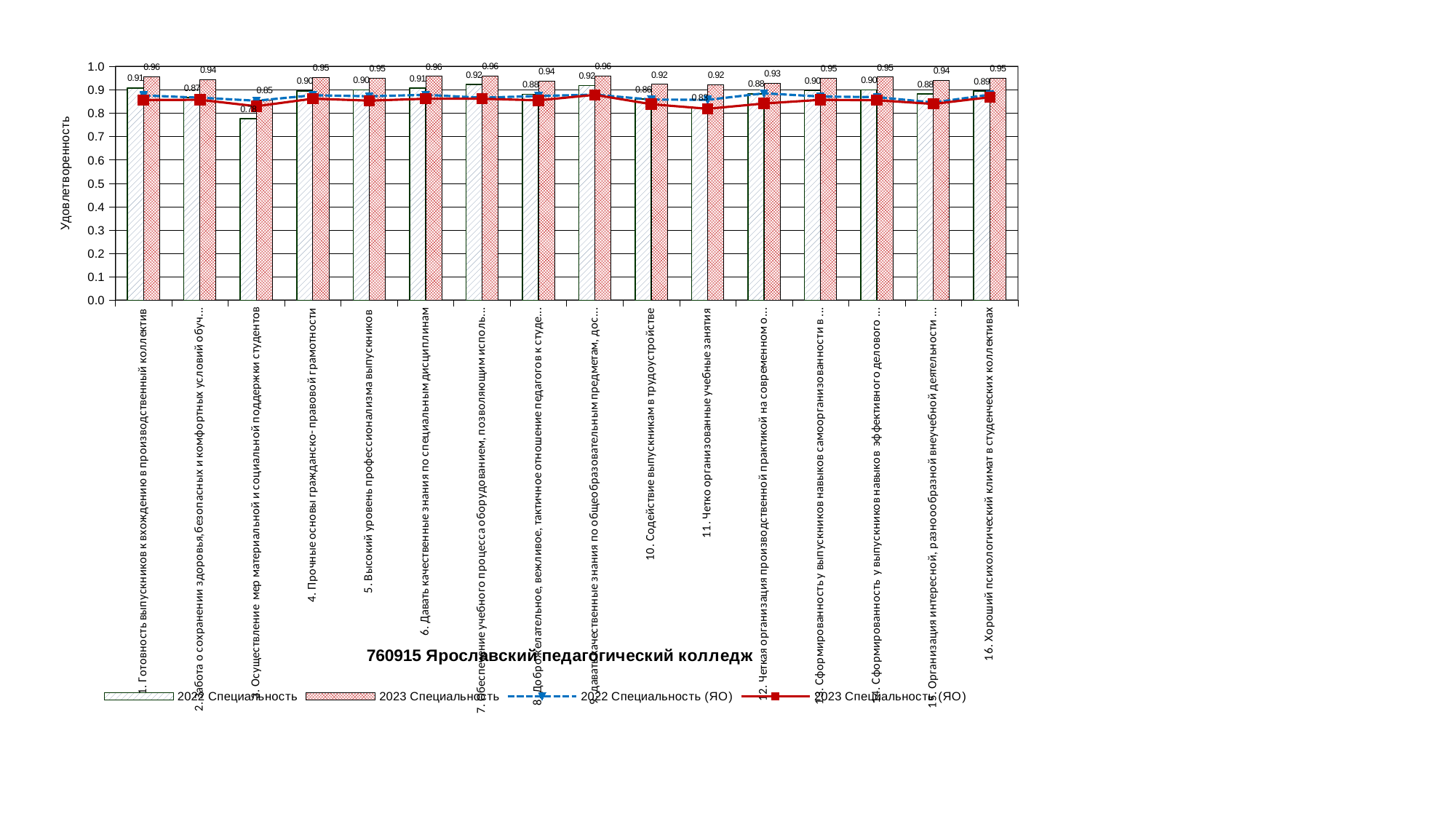
What is the 2022 Специальность value for category 1 (Готовность выпускников к вхождению в производственный коллектив)? 0.91 What is the 2022 Специальность value for category 5 (Высокий уровень профессионализма выпускников)? 0.90 What is the 2023 Специальность value for category 16 (Хороший психологический климат в студенческих коллективах)? 0.95 What is the 2023 Специальность value for category 10 (Содействие выпускникам в трудоустройстве)? 0.92 Which category has the lowest 2023 Специальность bar? 3. Осуществление мер материальной и социальной поддержки студентов How many series does the legend list? 4 What is the title of the chart? 760915 Ярославский педагогический колледж Is the 2022 Специальность value for category 3 greater or less than 0.8? less For category 10 (Содействие выпускникам в трудоустройстве), which is larger: the 2022 Специальность bar or the 2023 Специальность bar? 2023 Специальность What is the difference between the 2023 and 2022 Специальность values for category 16? 0.06 What is the difference between the 2023 and 2022 Специальность values for category 1? 0.05 How many categories are shown on the x axis? 16